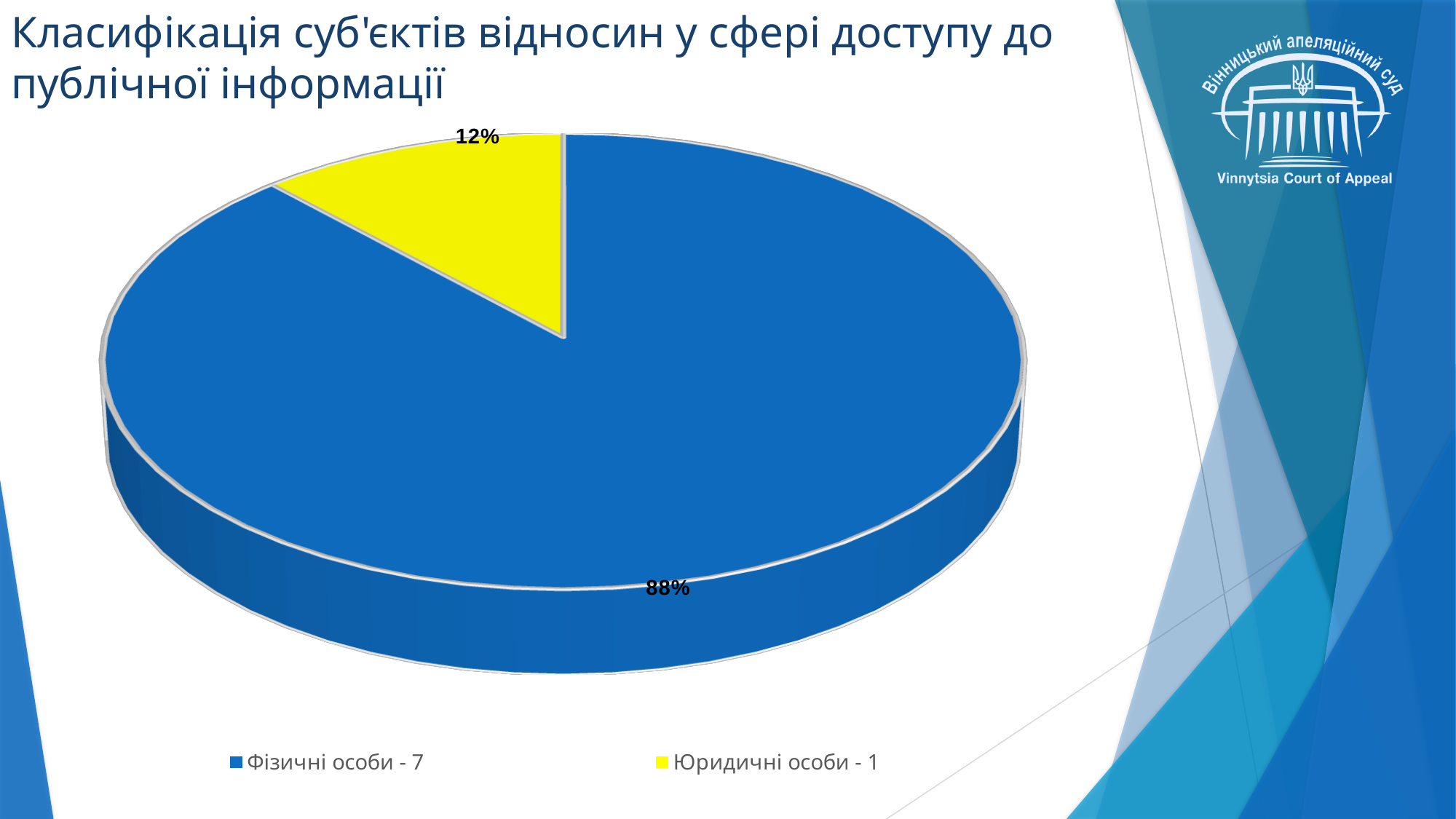
What percentage share does the slice for Юридичні особи - 1 have? 12% What colour is the slice for Юридичні особи - 1? yellow Which category has the largest slice of the pie? Фізичні особи - 7 Which slice is larger: Фізичні особи - 7 or Юридичні особи - 1? Фізичні особи - 7 What kind of chart is shown on the slide? pie chart How many entries does the legend list? 2 Which category has the smallest slice of the pie? Юридичні особи - 1 What is the title of the slide containing the chart? Класифікація суб'єктів відносин у сфері доступу до публічної інформації How many slices does the pie chart have? 2 What percentage share does the slice for Фізичні особи - 7 have? 88% What is the difference in percentage points between the shares of Фізичні особи - 7 and Юридичні особи - 1? 76